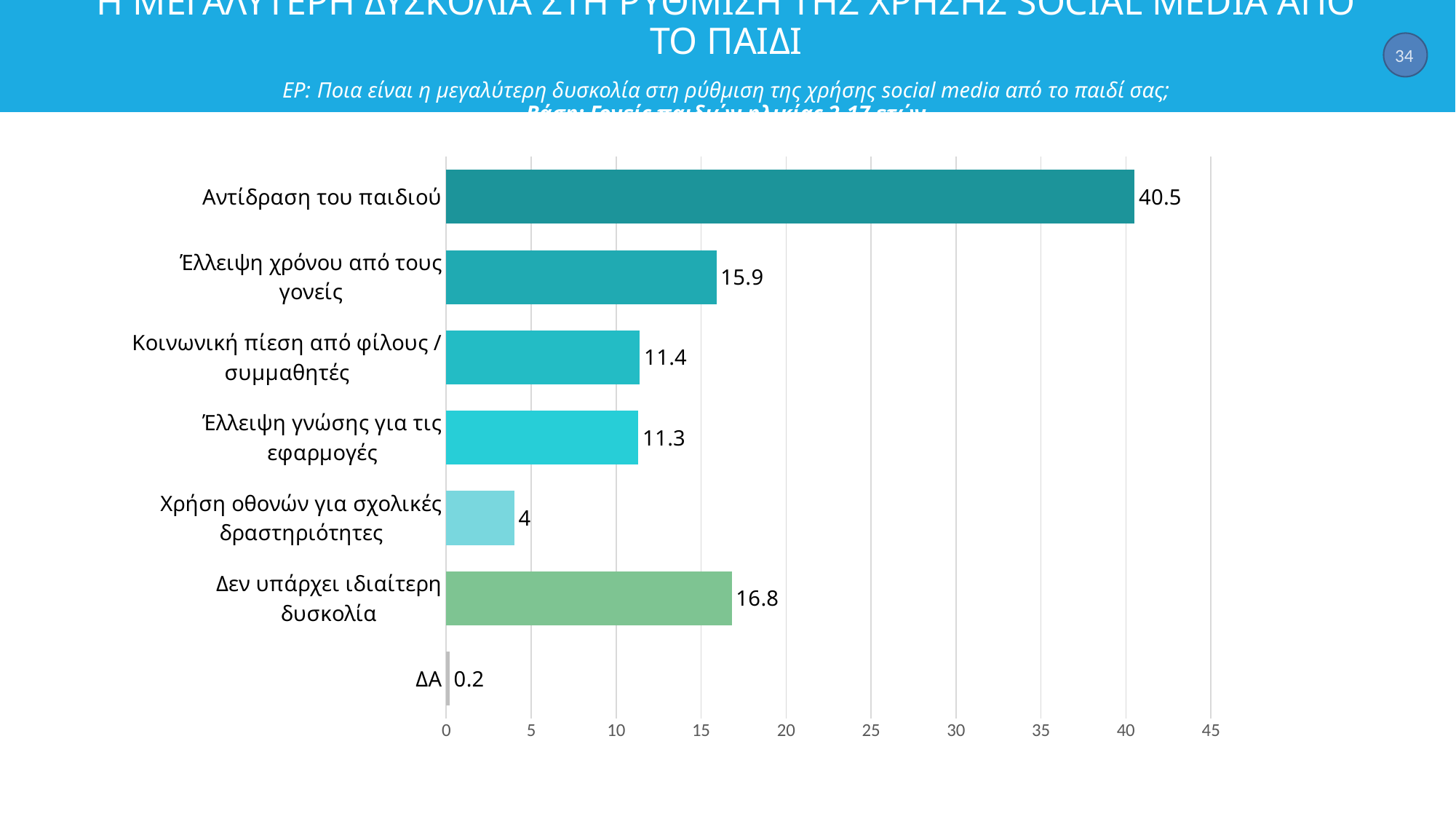
Which is larger, the value for Δεν υπάρχει ιδιαίτερη δυσκολία or the value for Έλλειψη χρόνου από τους γονείς? Δεν υπάρχει ιδιαίτερη δυσκολία Is the value for Έλλειψη γνώσης για τις εφαρμογές greater or less than 15? less What kind of chart is shown on the slide? bar chart Which category has the highest value? Αντίδραση του παιδιού What is the value for ΔΑ? 0.2 What is the value for Δεν υπάρχει ιδιαίτερη δυσκολία? 16.8 What is the value for Αντίδραση του παιδιού? 40.5 Which category has the lowest value? ΔΑ What is the difference between the values for Δεν υπάρχει ιδιαίτερη δυσκολία and Κοινωνική πίεση από φίλους / συμμαθητές? 5.4 How many categories are shown in the chart? 7 What is the value for Χρήση οθονών για σχολικές δραστηριότητες? 4 What is the difference between the values for Αντίδραση του παιδιού and Έλλειψη χρόνου από τους γονείς? 24.6